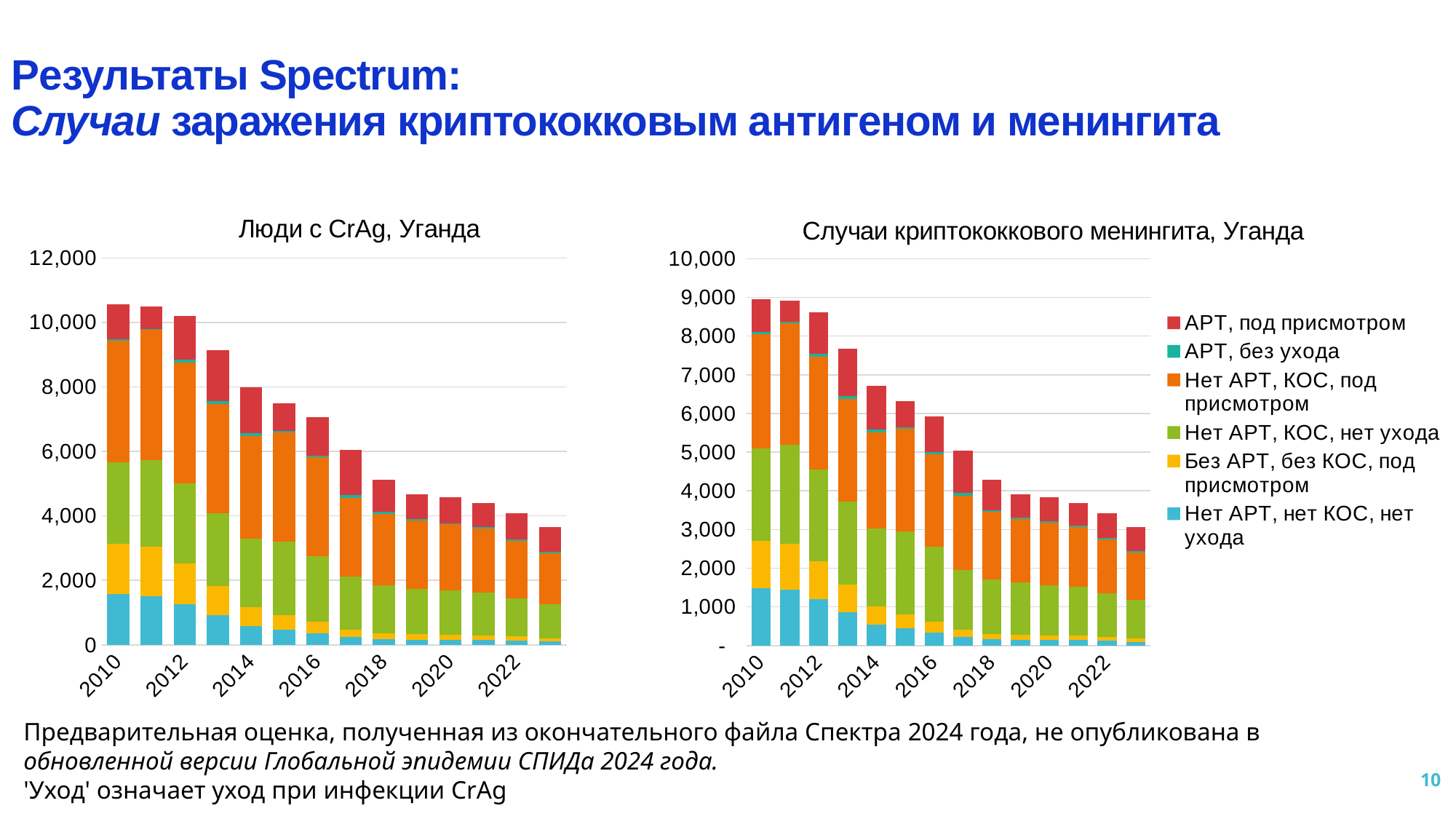
In the chart "Люди с CrAg, Уганда", do the total bar heights rise or fall from 2010 to 2023? fall In the chart "Люди с CrAg, Уганда", is the total for 2010 greater or less than 10,000? greater How many series does the legend list for the charts on the slide? 6 In the chart "Случаи криптококкового менингита, Уганда", which year has the tallest bar? 2010 How many bars (years) are plotted in the chart "Люди с CrAg, Уганда"? 14 What is the title of the right-hand chart on the slide? Случаи криптококкового менингита, Уганда What kind of chart is the chart titled "Люди с CrAg, Уганда"? stacked bar chart In the chart "Случаи криптококкового менингита, Уганда", is the total for 2020 greater or less than 4,000? less In the chart "Люди с CrAg, Уганда", which year has the shortest bar? 2023 In the chart "Случаи криптококкового менингита, Уганда", which bar is taller, 2012 or 2013? 2012 In the chart "Случаи криптококкового менингита, Уганда", is the total for 2013 greater or less than 7,000? greater